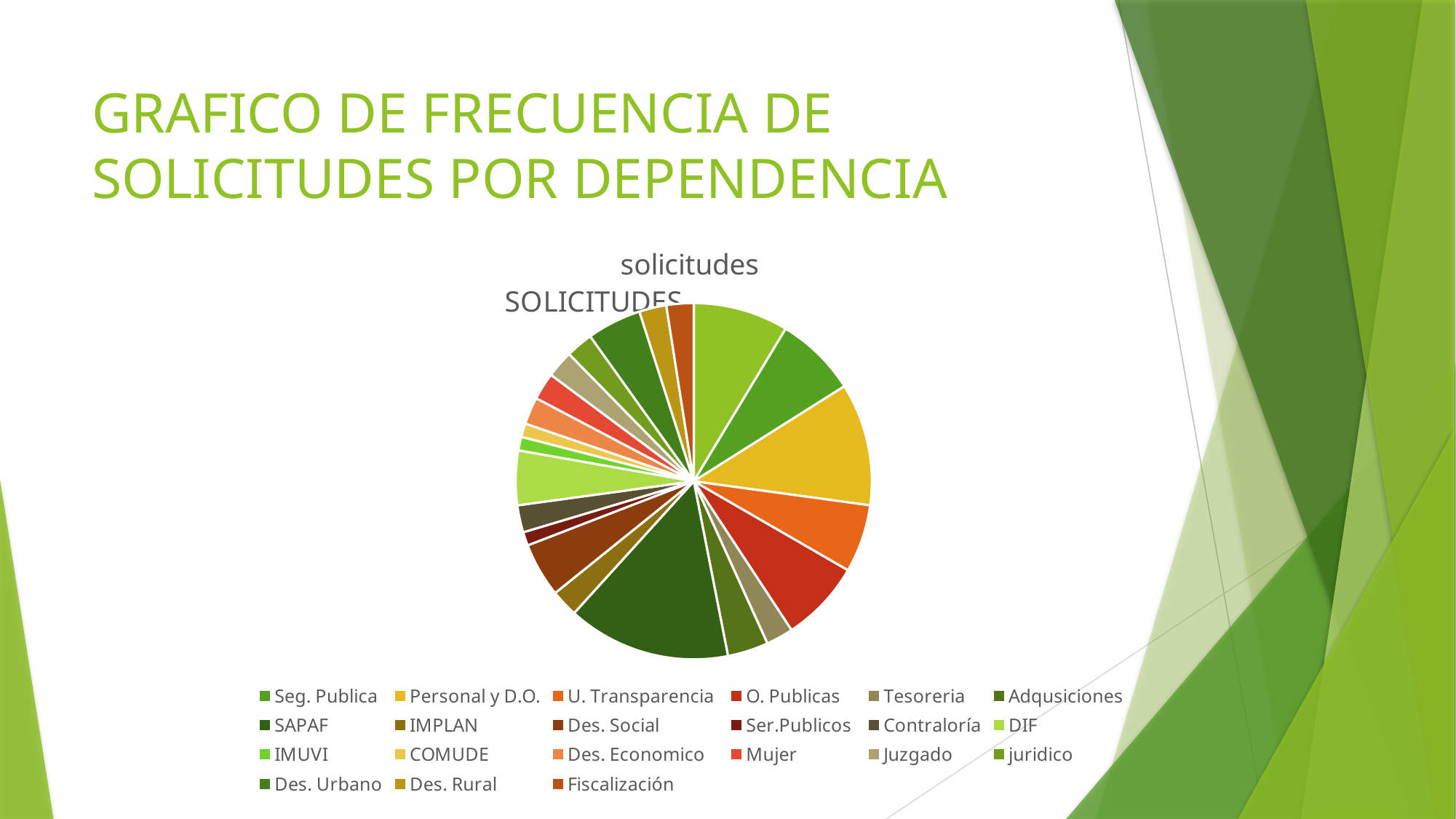
Which category is listed last in the legend of the pie chart? Fiscalización Which slice is larger, Seg. Publica or Tesoreria? Seg. Publica What colour is used for the Personal y D.O. slice in the pie chart? yellow Which slice is larger, SAPAF or Juzgado? SAPAF Which category has the largest slice in the pie chart? SAPAF Which slice is larger, Personal y D.O. or U. Transparencia? Personal y D.O. What is the title shown above the pie chart? solicitudes How many categories does the legend of the pie chart list? 21 What kind of chart is shown on the slide? pie chart